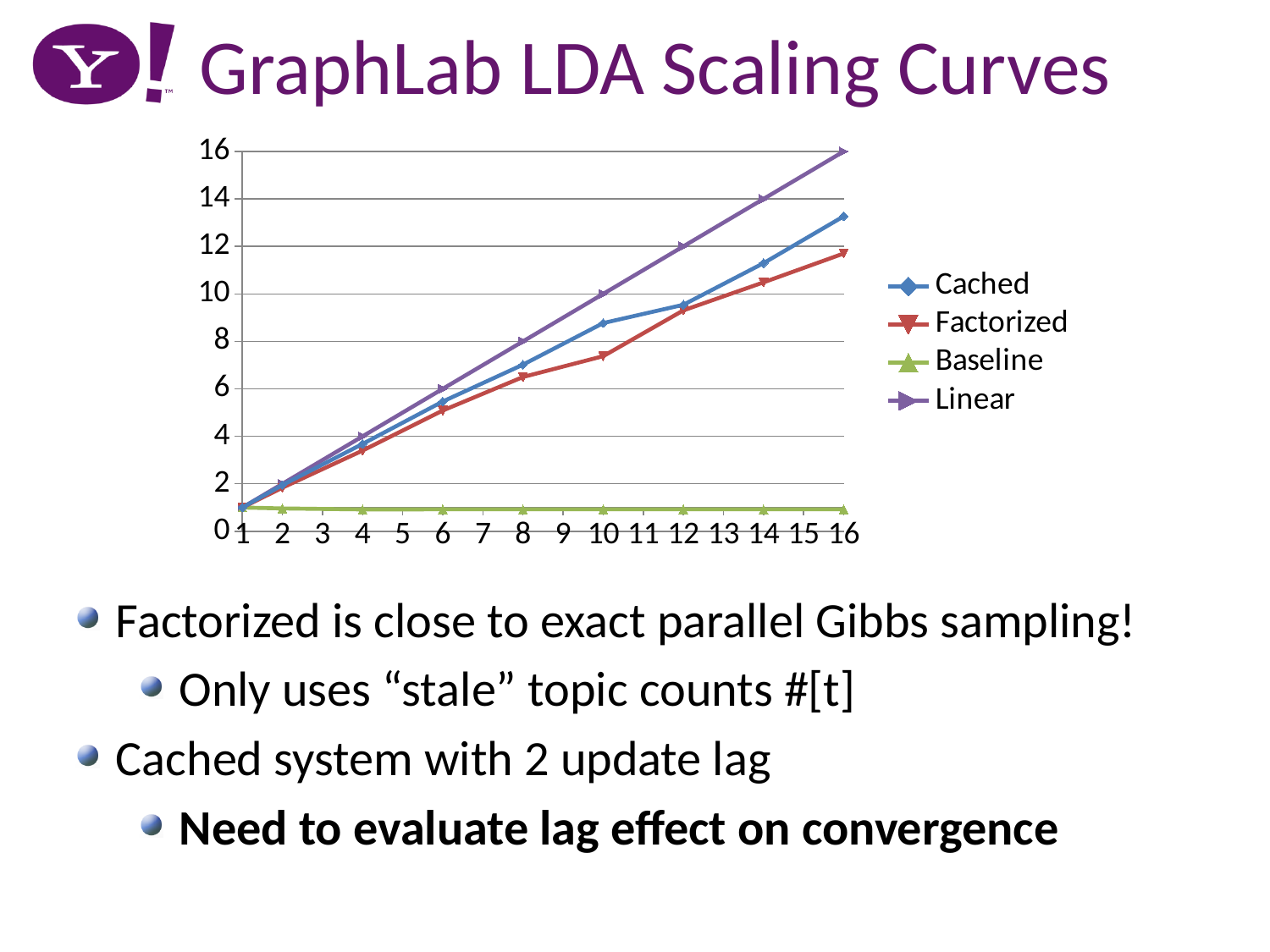
Which series is drawn in green? Baseline Does the Cached series rise or fall as x increases from 1 to 16? rise How many series does the legend list? 4 Is the value for Factorized at x = 10 greater or less than 8? less Is the value for Factorized at x = 16 greater or less than 12? less At x = 16, which is larger, the Cached value or the Factorized value? Cached Which series has the lowest values across the chart? Baseline What is the value of the Linear series at x = 16? 16 What kind of chart is shown on the slide? line chart What is the value of the Linear series at x = 8? 8 Is the value for Cached at x = 16 greater or less than 12? greater Which series reaches the highest value at x = 16? Linear